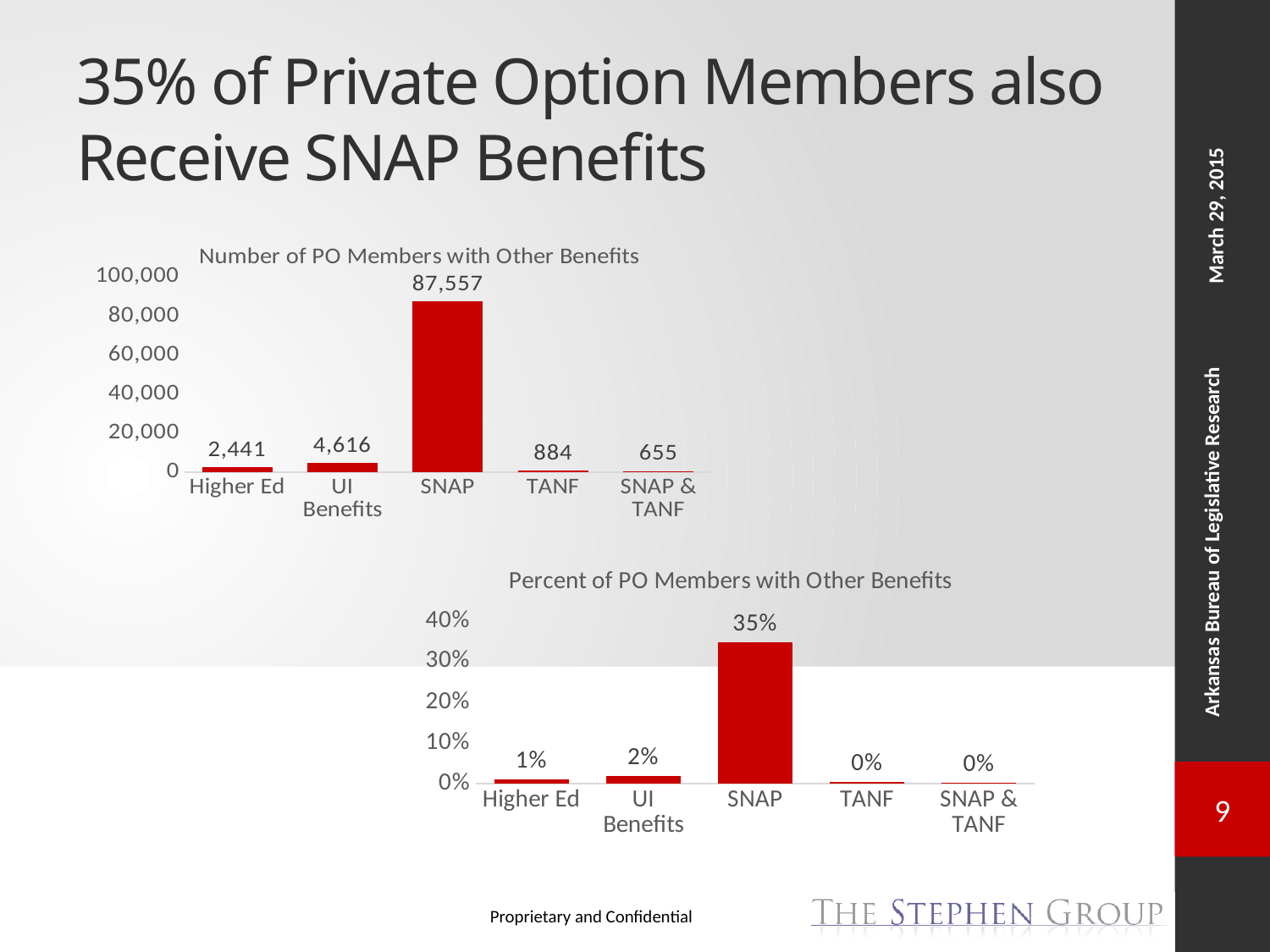
In the 'Number of PO Members with Other Benefits' chart, which category has the lowest value? SNAP & TANF In the 'Number of PO Members with Other Benefits' chart, which is larger, Higher Ed or UI Benefits? UI Benefits In the 'Number of PO Members with Other Benefits' chart, how many PO members receive SNAP? 87,557 In the 'Number of PO Members with Other Benefits' chart, what is the value for UI Benefits? 4,616 What type of chart is the 'Percent of PO Members with Other Benefits' chart? bar chart In the 'Percent of PO Members with Other Benefits' chart, what is the value for Higher Ed? 1% In the 'Percent of PO Members with Other Benefits' chart, what percent of PO members receive SNAP? 35% In the 'Number of PO Members with Other Benefits' chart, what is the difference between the Higher Ed and TANF values? 1,557 In the 'Percent of PO Members with Other Benefits' chart, which category has the highest value? SNAP In the 'Number of PO Members with Other Benefits' chart, is the value for SNAP greater or less than 80,000? greater How many categories are shown in the 'Number of PO Members with Other Benefits' chart? 5 What is the title of the top chart on the slide? Number of PO Members with Other Benefits